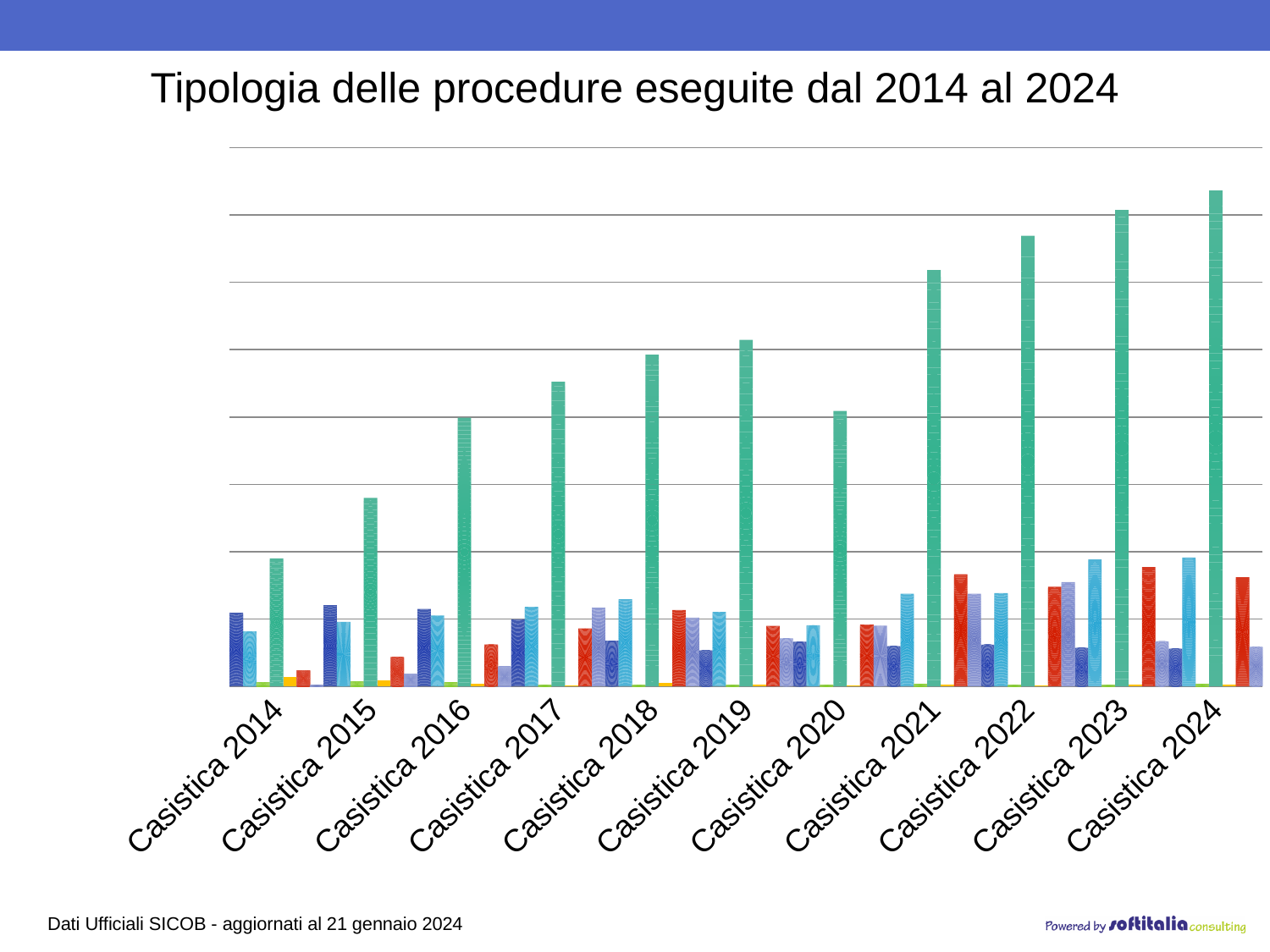
Is the green bar taller for Casistica 2023 or for Casistica 2024? Casistica 2024 What kind of chart is shown on the slide? Bar chart Which category contains the tallest bar on the chart? Casistica 2024 Which category has the shortest green bar on the chart? Casistica 2014 Do the green bars generally rise or fall from Casistica 2014 to Casistica 2024? Rise Is the green bar taller for Casistica 2019 or for Casistica 2020? Casistica 2019 What is the label of the first category on the x axis? Casistica 2014 How many categories are shown on the x axis of the chart? 11 What is the title of the chart? Tipologia delle procedure eseguite dal 2014 al 2024